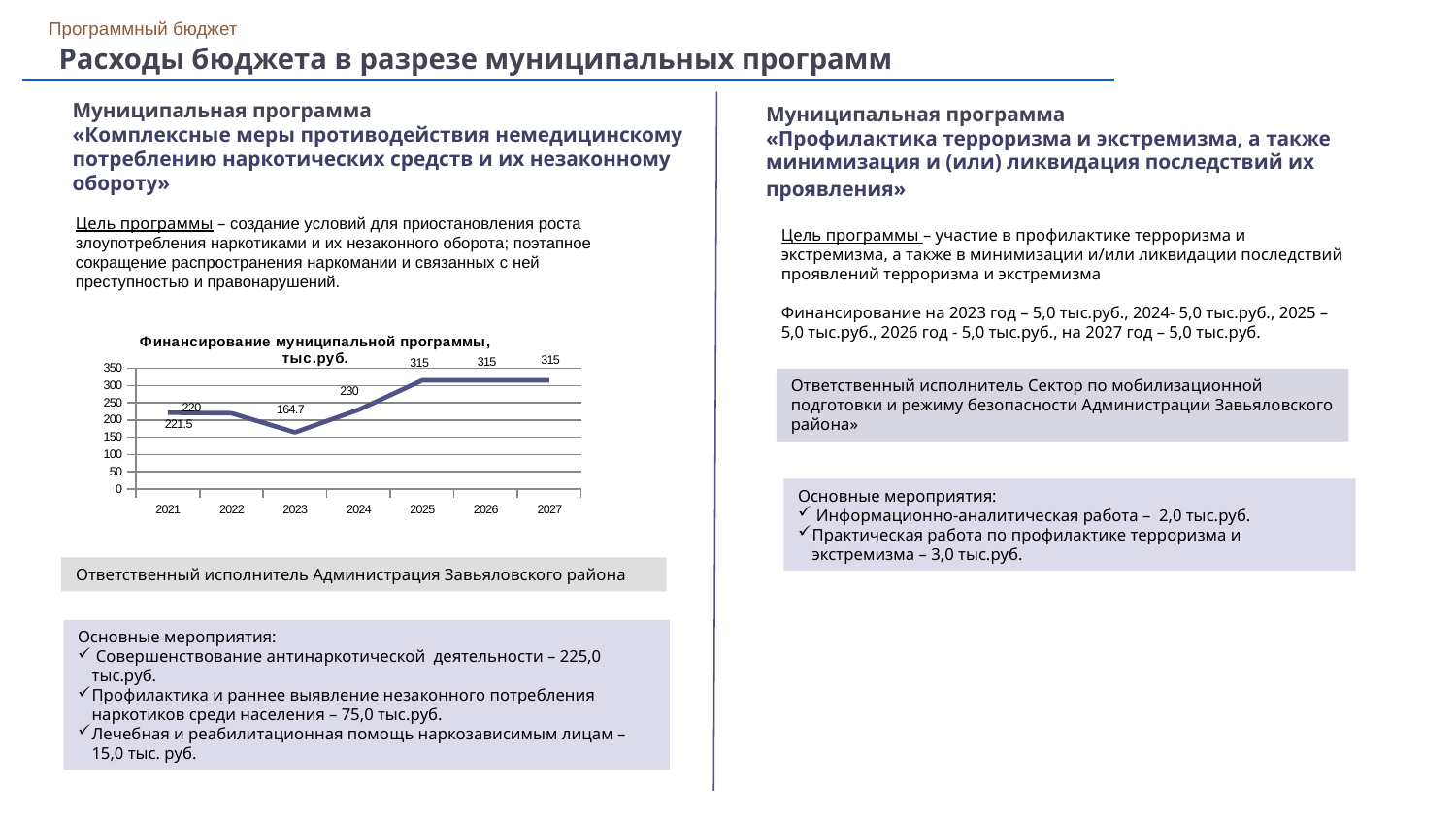
What is the financing value for 2027 in the chart 'Финансирование муниципальной программы, тыс.руб.'? 315 What is the financing value for 2024 in the chart 'Финансирование муниципальной программы, тыс.руб.'? 230 Is the financing value for 2023 in the chart 'Финансирование муниципальной программы, тыс.руб.' greater or less than 200? less Which is larger in the chart 'Финансирование муниципальной программы, тыс.руб.': the value for 2022 or the value for 2023? 2022 What is the financing value for 2023 in the chart 'Финансирование муниципальной программы, тыс.руб.'? 164.7 Which year has the lowest financing value in the chart 'Финансирование муниципальной программы, тыс.руб.'? 2023 What type of chart is used to show the financing of the municipal programme (Финансирование муниципальной программы, тыс.руб.)? Line chart How many years are shown on the x axis of the chart 'Финансирование муниципальной программы, тыс.руб.'? 7 What is the difference between the financing values for 2021 and 2023 in the chart 'Финансирование муниципальной программы, тыс.руб.'? 56.8 What is the difference between the financing values for 2025 and 2024 in the chart 'Финансирование муниципальной программы, тыс.руб.'? 85 What is the financing value for 2021 in the chart 'Финансирование муниципальной программы, тыс.руб.'? 221.5 Does the financing value rise or fall from 2023 to 2025 in the chart 'Финансирование муниципальной программы, тыс.руб.'? rise